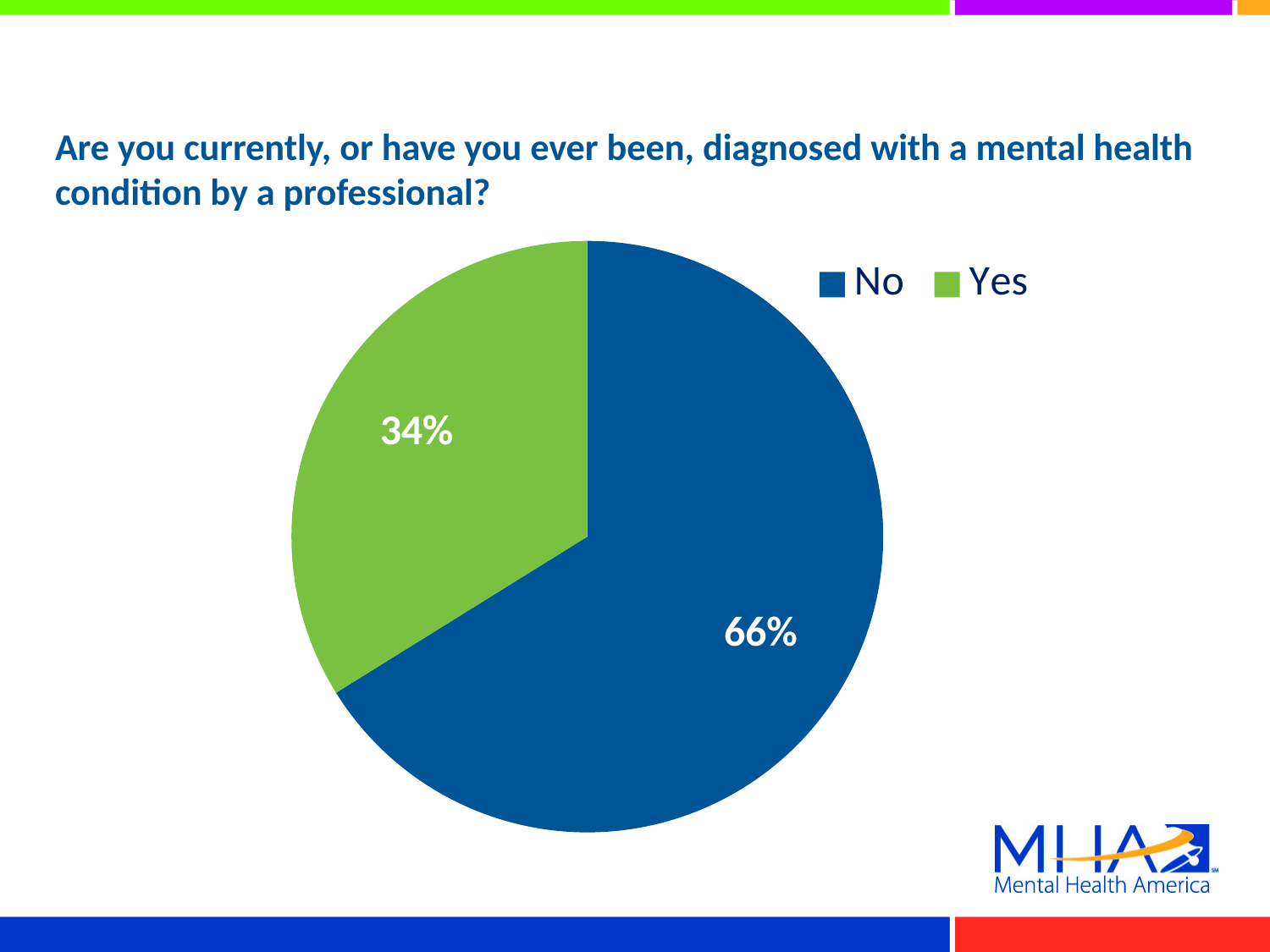
How many entries does the legend list? 2 What question does the chart title ask? Are you currently, or have you ever been, diagnosed with a mental health condition by a professional? What kind of chart is shown on the slide? Pie chart What percentage of respondents answered "No"? 66% Which is larger, the "Yes" slice or the "No" slice? No Which response has the largest share of the pie? No Which response has the smallest share of the pie? Yes What share of the pie does the "Yes" slice represent? 34% What colour is the "Yes" slice? Green How many slices does the pie chart have? 2 What percentage of respondents answered "Yes"? 34% What is the difference in percentage points between the "No" and "Yes" slices? 32